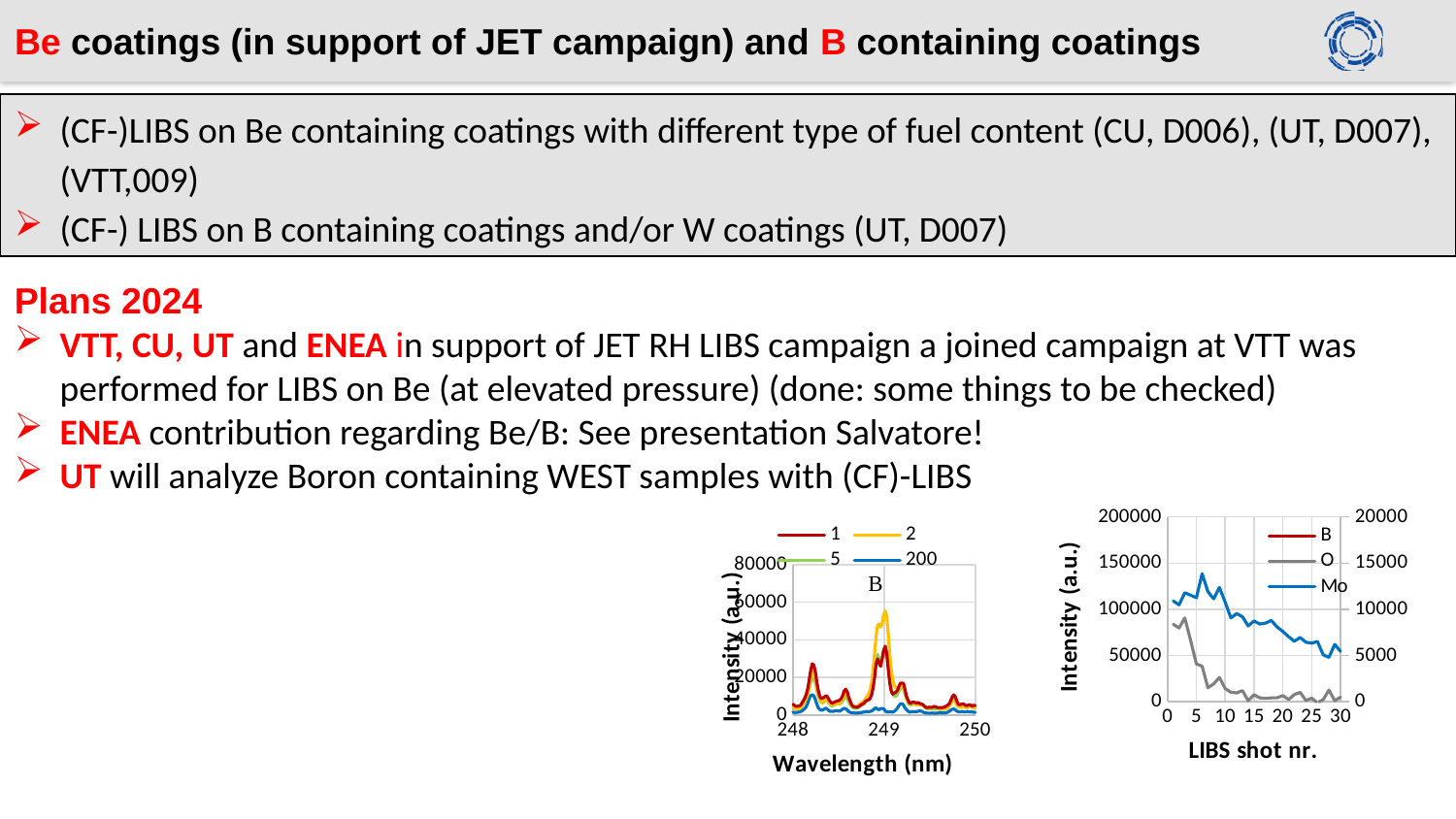
What kind of chart is the right chart (Intensity vs LIBS shot nr.)? line chart What is the x-axis label of the left chart? Wavelength (nm) How many series does the legend of the right chart (Intensity vs LIBS shot nr.) list? 3 How many series does the legend of the left chart (Intensity vs Wavelength) list? 4 In the right chart (Intensity vs LIBS shot nr.), is the value of the O series at shot 30 greater or less than 50000? less In the left chart (Intensity vs Wavelength), is the highest peak of series 2 greater or less than 40000? greater In the left chart (Intensity vs Wavelength), which series reaches the highest peak near 249 nm? 2 What are the legend entries of the left chart (Intensity vs Wavelength)? 1, 2, 5, 200 What kind of chart is the left chart (Intensity vs Wavelength)? line chart In the right chart (Intensity vs LIBS shot nr.), does the Mo series rise or fall as the shot number increases? fall In the right chart (Intensity vs LIBS shot nr.), does the O series rise or fall as the shot number increases? fall In the left chart (Intensity vs Wavelength), is the highest value of series 200 greater or less than 20000? less